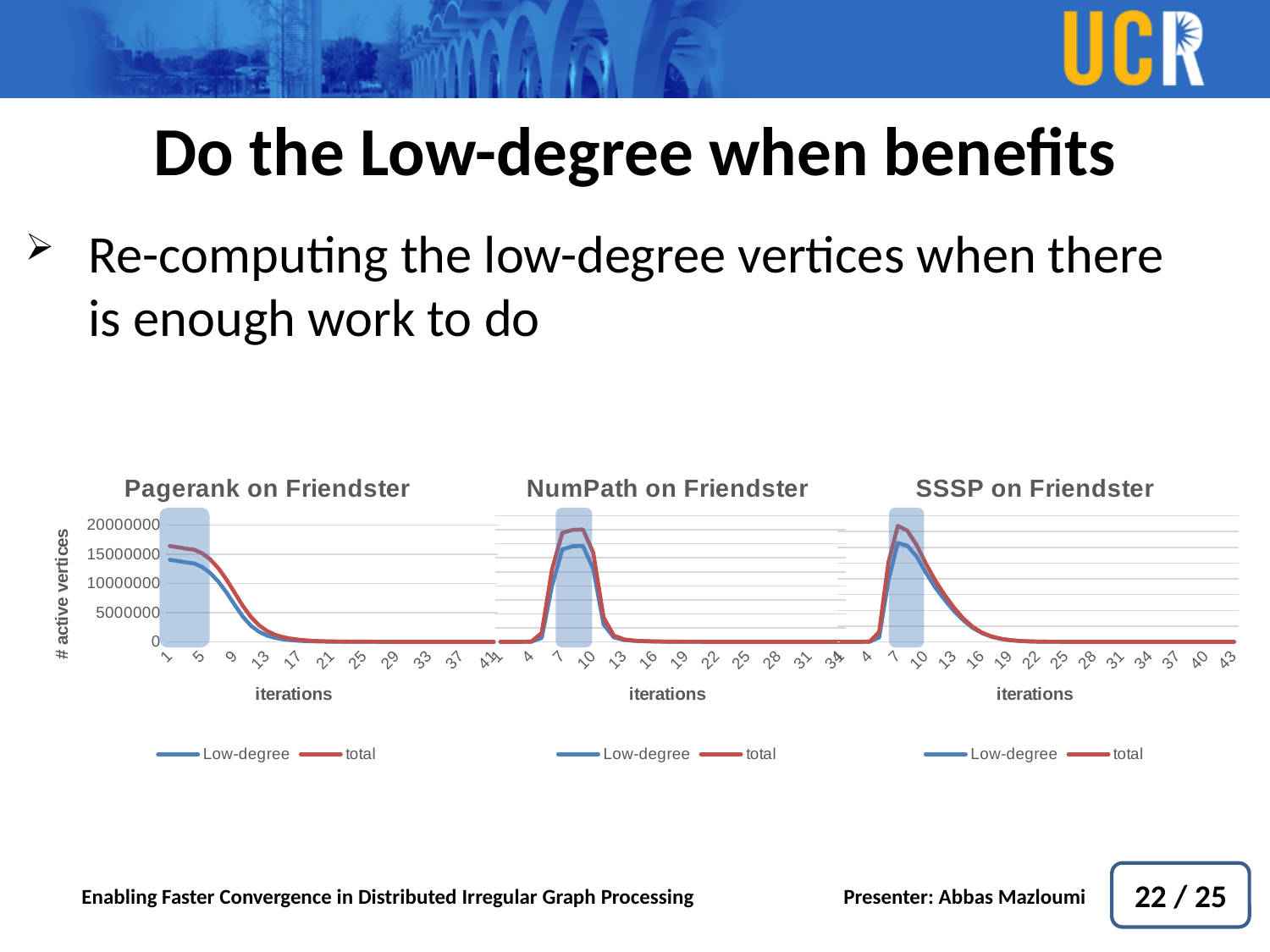
What are the two series named in the legend of the 'SSSP on Friendster' chart? Low-degree and total What is the y-axis label on the 'Pagerank on Friendster' chart? # active vertices Which series is drawn in red in the 'SSSP on Friendster' chart? total In the 'Pagerank on Friendster' chart, is the 'total' value at iteration 1 greater or less than 10000000? greater In the 'Pagerank on Friendster' chart, is the 'Low-degree' value at iteration 13 greater or less than 5000000? less In the 'NumPath on Friendster' chart, which series reaches the higher peak, 'Low-degree' or 'total'? total In the 'Pagerank on Friendster' chart, do the values of the 'total' series rise or fall as the iterations increase? fall In the 'Pagerank on Friendster' chart, at iteration 5, which series has the larger value, 'Low-degree' or 'total'? total What kind of chart is the 'Pagerank on Friendster' chart? line chart In the 'SSSP on Friendster' chart, do the values rise or fall after iteration 10? fall In the 'NumPath on Friendster' chart, is the 'total' value at iteration 25 greater or less than 5000000? less How many series does the legend of the 'NumPath on Friendster' chart list? 2